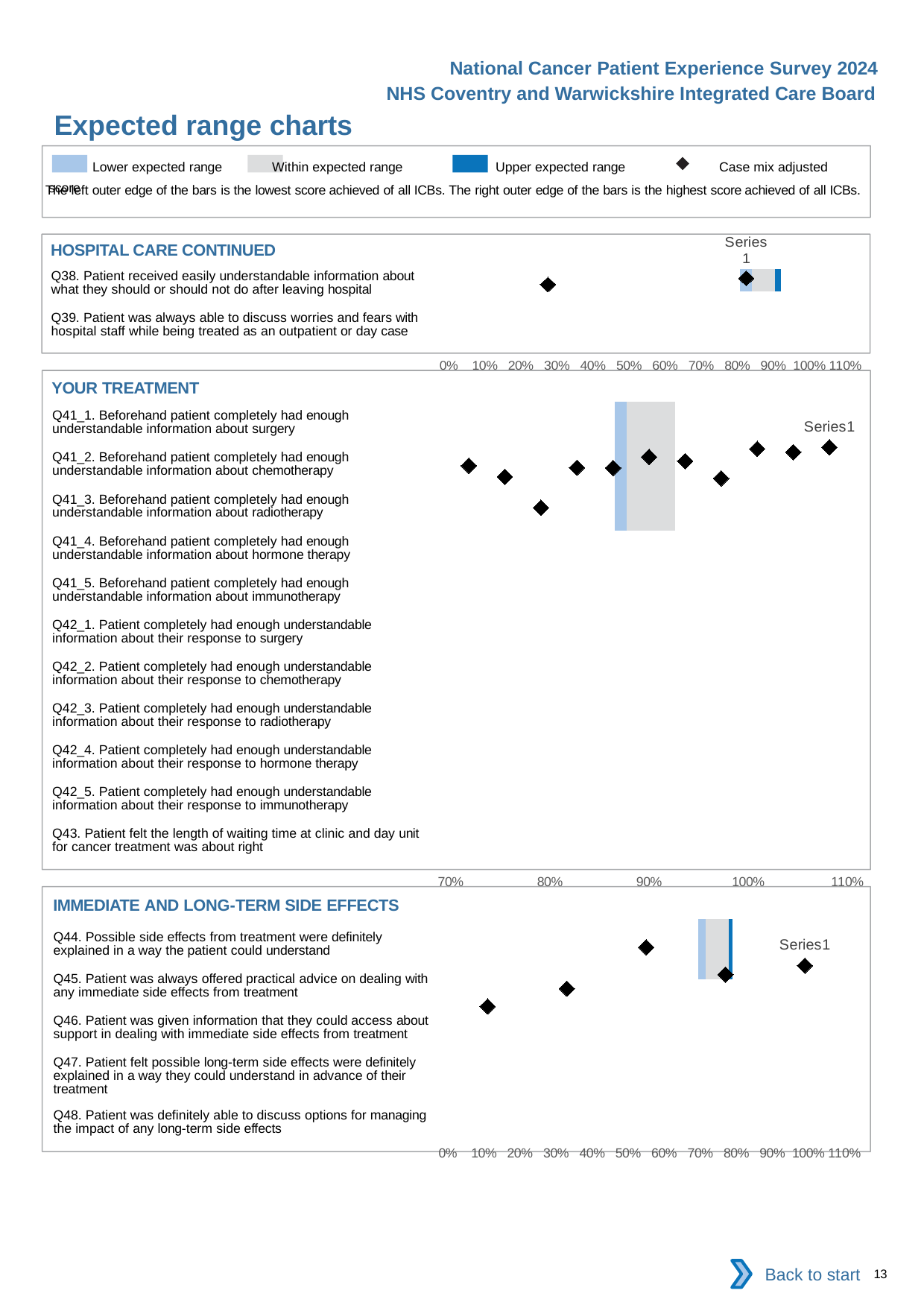
In the HOSPITAL CARE CONTINUED chart, how many plotted points are greater than 50%? 1 How many series does the legend of the YOUR TREATMENT chart list? 1 What is the title of the slide containing the charts? Expected range charts In the IMMEDIATE AND LONG-TERM SIDE EFFECTS chart, how many plotted points are greater than 40%? 3 How many categories (questions) are listed in the HOSPITAL CARE CONTINUED chart? 2 In the YOUR TREATMENT chart, are all plotted points greater or less than 110%? less What is the lowest axis tick shown on the YOUR TREATMENT chart? 70% What is the name of the series shown in the legend of the IMMEDIATE AND LONG-TERM SIDE EFFECTS chart? Series1 In the IMMEDIATE AND LONG-TERM SIDE EFFECTS chart, are all plotted points greater or less than 110%? less